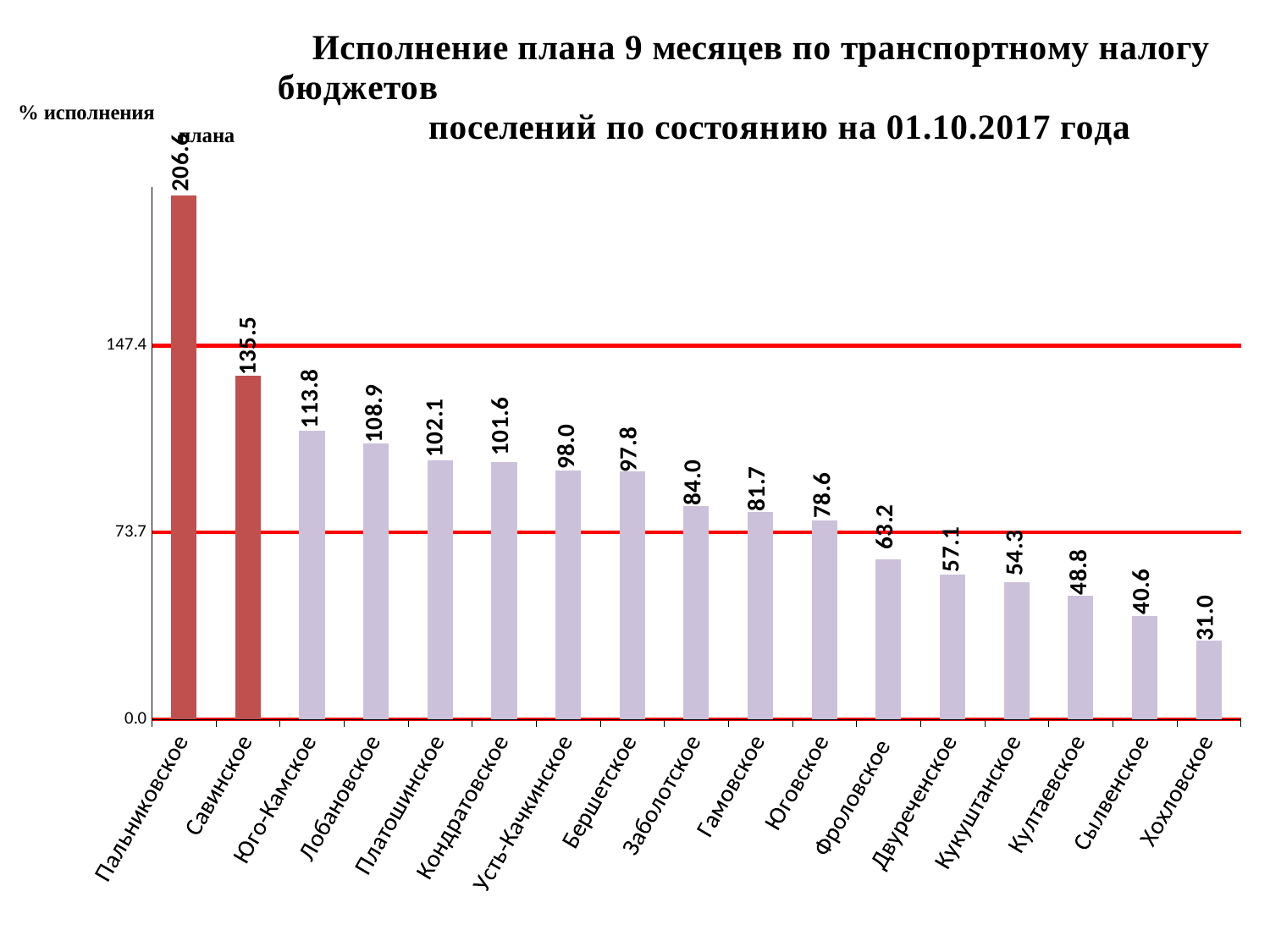
Which settlement has the highest value? Пальниковское What kind of chart is shown on the slide? bar chart How many settlements are shown on the chart? 17 What is the difference between the values for Лобановское and Платошинское? 6.8 Which settlement has the lowest value? Хохловское What is the value for Савинское? 135.5 Which is larger, the value for Заболотское or the value for Гамовское? Заболотское Is the value for Юговское greater or less than 73.7? greater What is the value for Фроловское? 63.2 Do the values rise or fall from left to right along the x axis? fall What is the value for Юго-Камское? 113.8 What is the value for Хохловское? 31.0